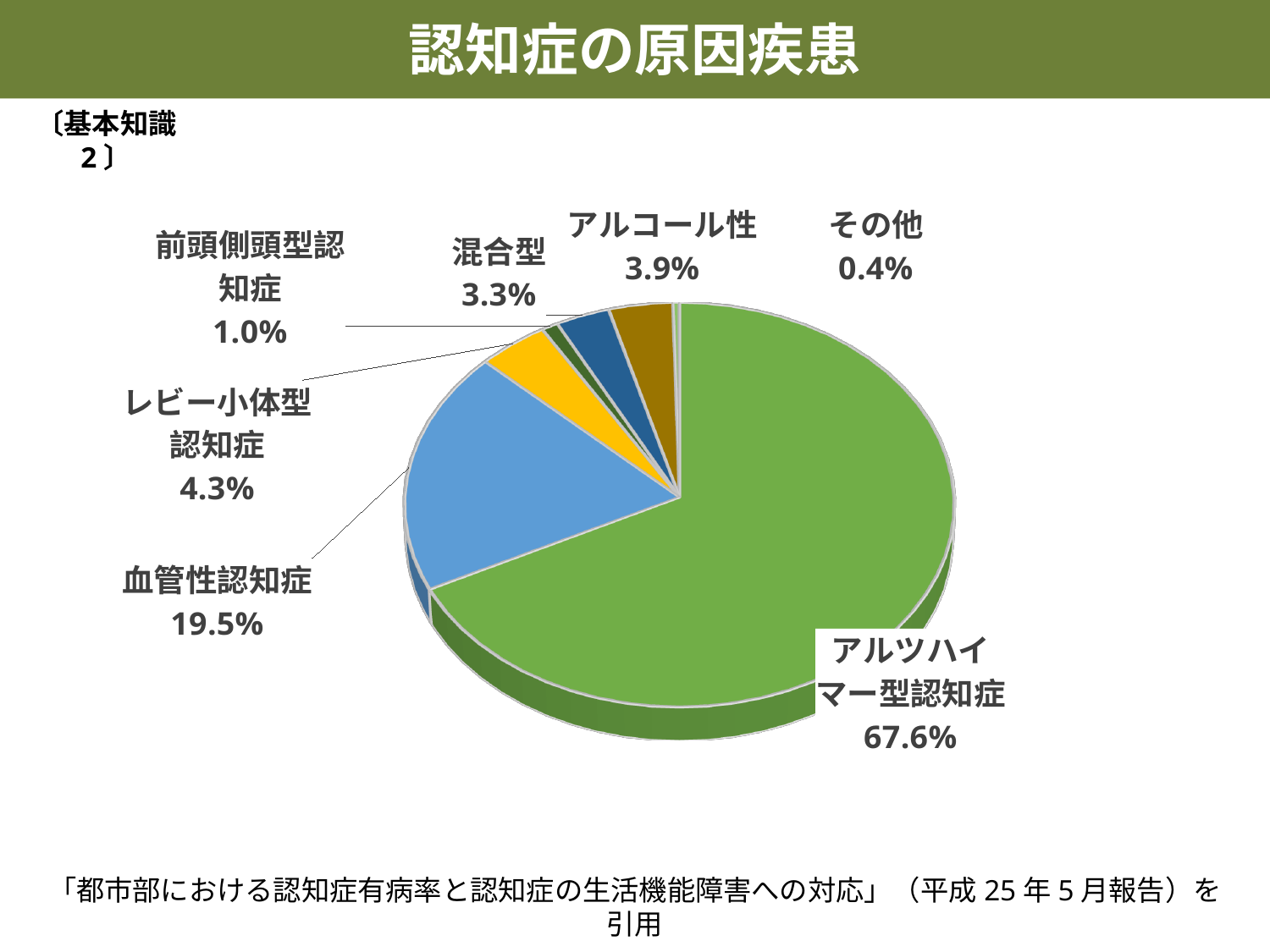
What is the title of the chart on the slide? 認知症の原因疾患 Which category has the largest slice of the pie? アルツハイマー型認知症 What is the share for アルツハイマー型認知症? 67.6% What is the share for 混合型? 3.3% Which is larger, the share for レビー小体型認知症 or the share for 前頭側頭型認知症? レビー小体型認知症 How many categories are shown in the pie chart? 7 What type of chart is shown on the slide? Pie chart What is the share for 血管性認知症? 19.5% What is the difference between the shares of アルツハイマー型認知症 and 血管性認知症? 48.1% What is the share for アルコール性? 3.9% Which category has the smallest slice of the pie? その他 What is the share for レビー小体型認知症? 4.3%